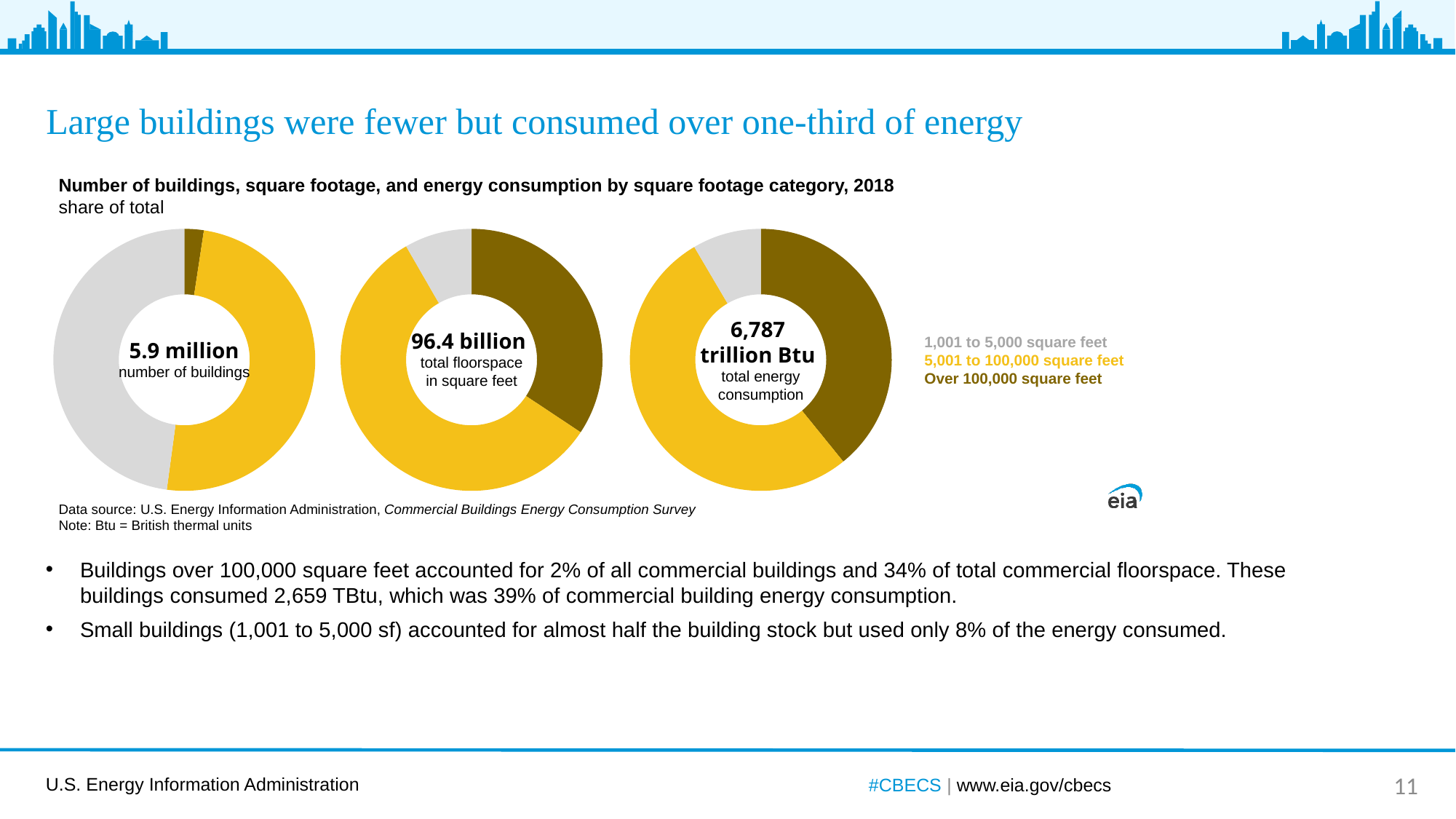
In the number of buildings donut chart, which square footage category has the smallest share? Over 100,000 square feet In the total energy consumption donut chart, which has the larger share: Over 100,000 square feet or 1,001 to 5,000 square feet? Over 100,000 square feet What is the title of the chart group on this slide? Number of buildings, square footage, and energy consumption by square footage category, 2018 How many square footage categories does the legend list? 3 In the total energy consumption donut chart, what total is printed in the center? 6,787 trillion Btu In the total floorspace donut chart, which square footage category has the largest share? 5,001 to 100,000 square feet What kind of chart is used to show the shares on this slide? Pie (donut) chart In the total floorspace donut chart, what total is printed in the center? 96.4 billion How many donut charts are shown on the slide? 3 In the number of buildings donut chart, what total is printed in the center? 5.9 million In the total energy consumption donut chart, which square footage category has the largest share? 5,001 to 100,000 square feet In the total energy consumption donut chart, which square footage category has the smallest share? 1,001 to 5,000 square feet